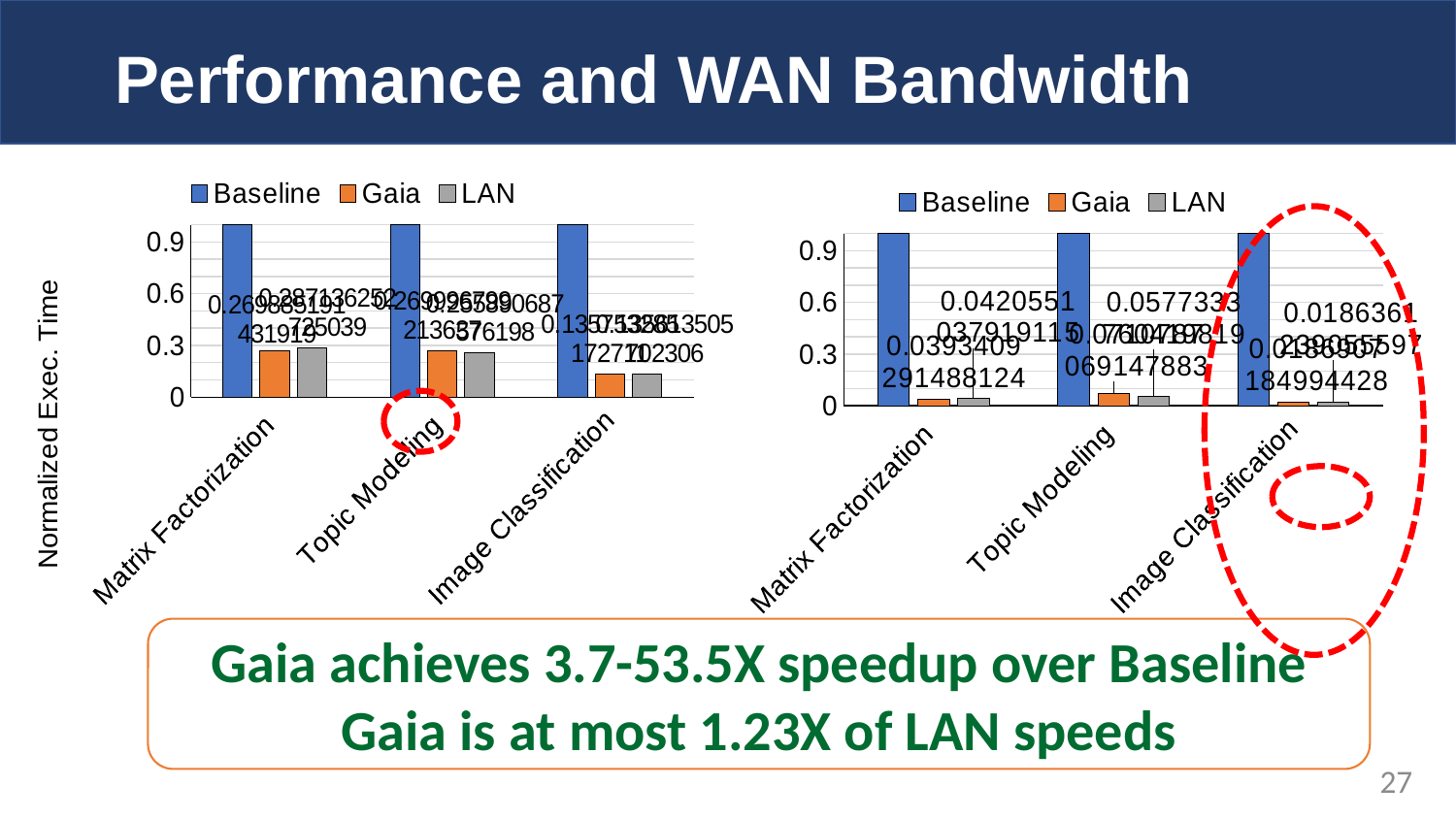
In the left chart, is the Baseline value for Matrix Factorization greater or less than 0.9? greater In the right chart, is the LAN value for Matrix Factorization greater or less than 0.3? less What kind of chart is the left chart on the slide? bar chart In the left chart, which category has the lowest Gaia value? Image Classification What are the three legend entries of the left chart? Baseline, Gaia, LAN How many series does the legend of the right chart list? 3 In the left chart, which is larger for Image Classification: the Baseline value or the Gaia value? Baseline In the left chart, is the Gaia value for Image Classification greater or less than 0.3? less In the right chart, which series has the highest value for Image Classification? Baseline How many categories are shown on the x axis of the left chart? 3 In the left chart, which series has the highest value for Topic Modeling? Baseline